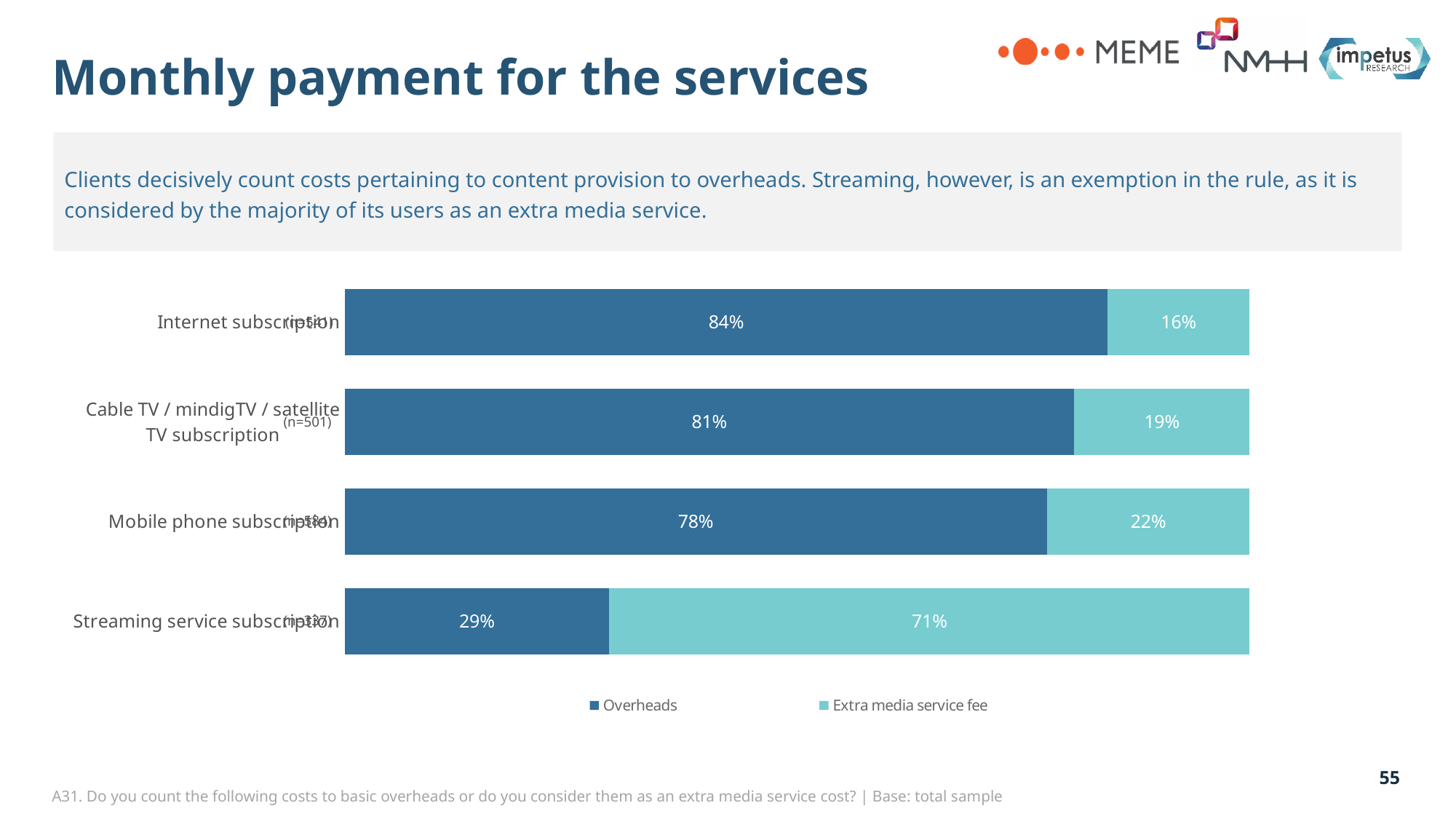
How many services are shown in the chart? 4 What is the Extra media service fee value for Cable TV / mindigTV / satellite TV subscription? 19% How many series does the legend list? 2 Which service has the lowest Overheads share? Streaming service subscription What is the Overheads value for Mobile phone subscription? 78% Which is larger: the Extra media service fee value for Mobile phone subscription or for Internet subscription? Mobile phone subscription Which service has the highest Overheads share? Internet subscription What percentage of respondents count Internet subscription as Overheads? 84% What is the Extra media service fee value for Streaming service subscription? 71% What is the difference between the Overheads values for Internet subscription and Mobile phone subscription? 6 percentage points What is the total of the two segments for the Streaming service subscription bar? 100% What kind of chart is shown on the slide? Stacked bar chart